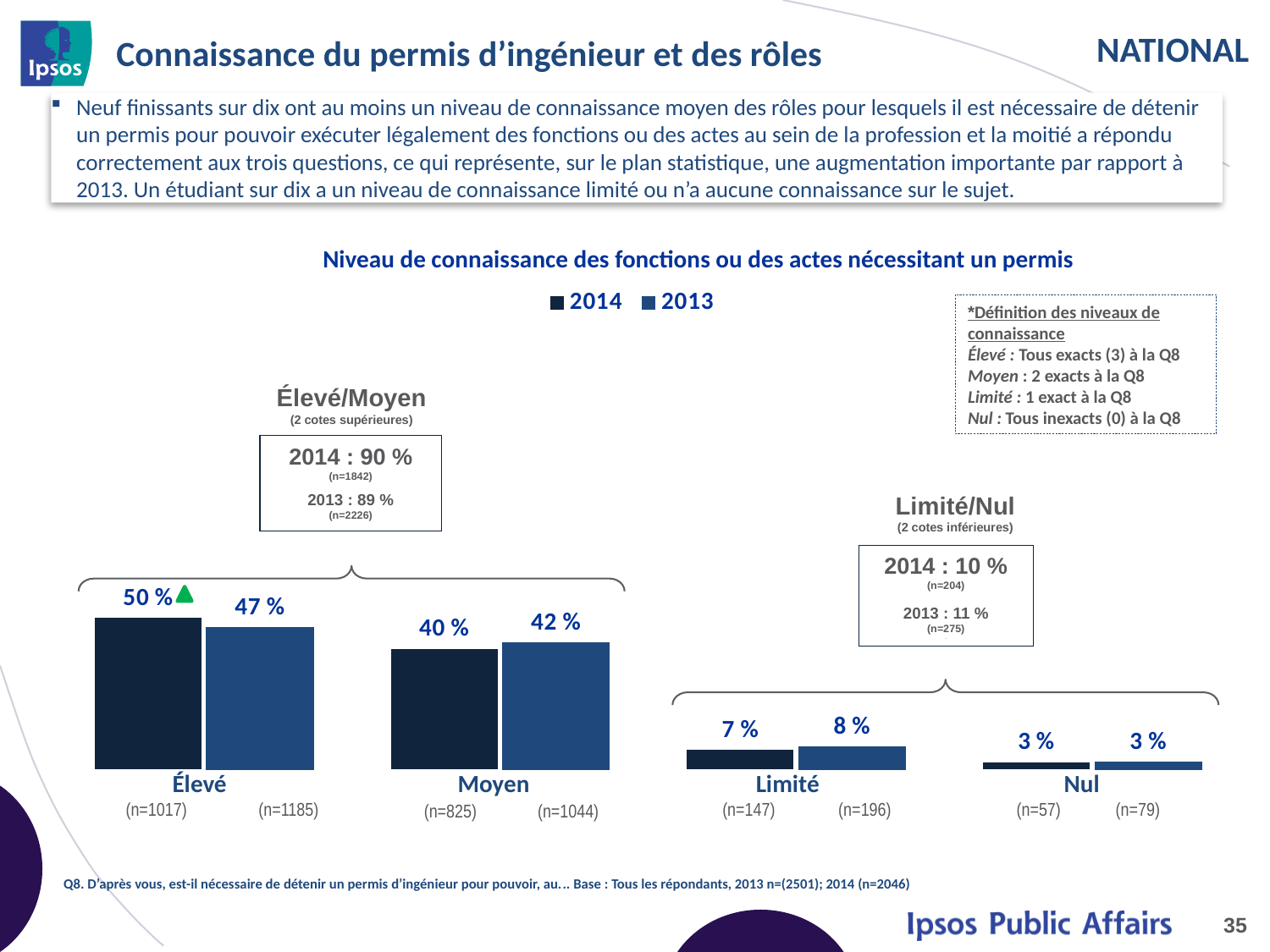
What is the difference between the 2014 and 2013 values for Élevé? 3 % What kind of chart is shown on the slide? Bar chart What is the 2014 value for Élevé? 50 % What is the title of the chart? Niveau de connaissance des fonctions ou des actes nécessitant un permis Which category has the highest 2014 value? Élevé What is the 2014 value for Limité? 7 % Which is larger for Moyen, the 2014 value or the 2013 value? 2013 What is the 2013 value for Moyen? 42 % Which category has the lowest 2013 value? Nul What is the 2013 value for Nul? 3 % How many series does the legend list? 2 How many categories are shown on the x axis of the chart? 4